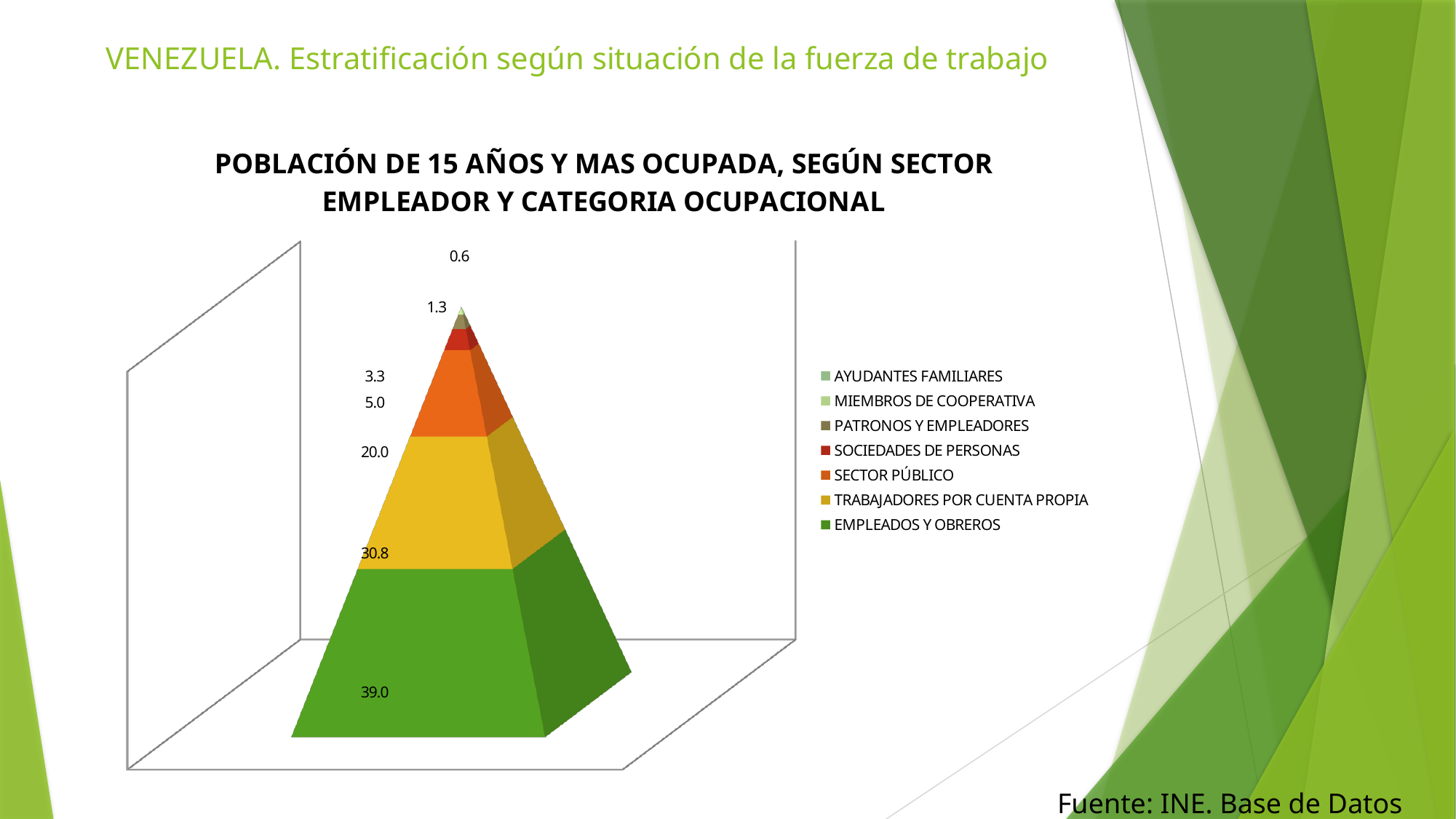
What is the total of all the segments in the stacked pyramid? 100.0 How many series does the legend list? 7 What value is shown for EMPLEADOS Y OBREROS? 39.0 Which is larger, the value for SECTOR PÚBLICO or the value for SOCIEDADES DE PERSONAS? SECTOR PÚBLICO What value is shown for SECTOR PÚBLICO? 20.0 What value is shown for SOCIEDADES DE PERSONAS? 5.0 Which category has the largest value? EMPLEADOS Y OBREROS Which category has the smallest value? AYUDANTES FAMILIARES What value is shown for TRABAJADORES POR CUENTA PROPIA? 30.8 What is the title of the chart? POBLACIÓN DE 15 AÑOS Y MAS OCUPADA, SEGÚN SECTOR EMPLEADOR Y CATEGORIA OCUPACIONAL What value is shown for AYUDANTES FAMILIARES? 0.6 What is the difference between the values for EMPLEADOS Y OBREROS and TRABAJADORES POR CUENTA PROPIA? 8.2